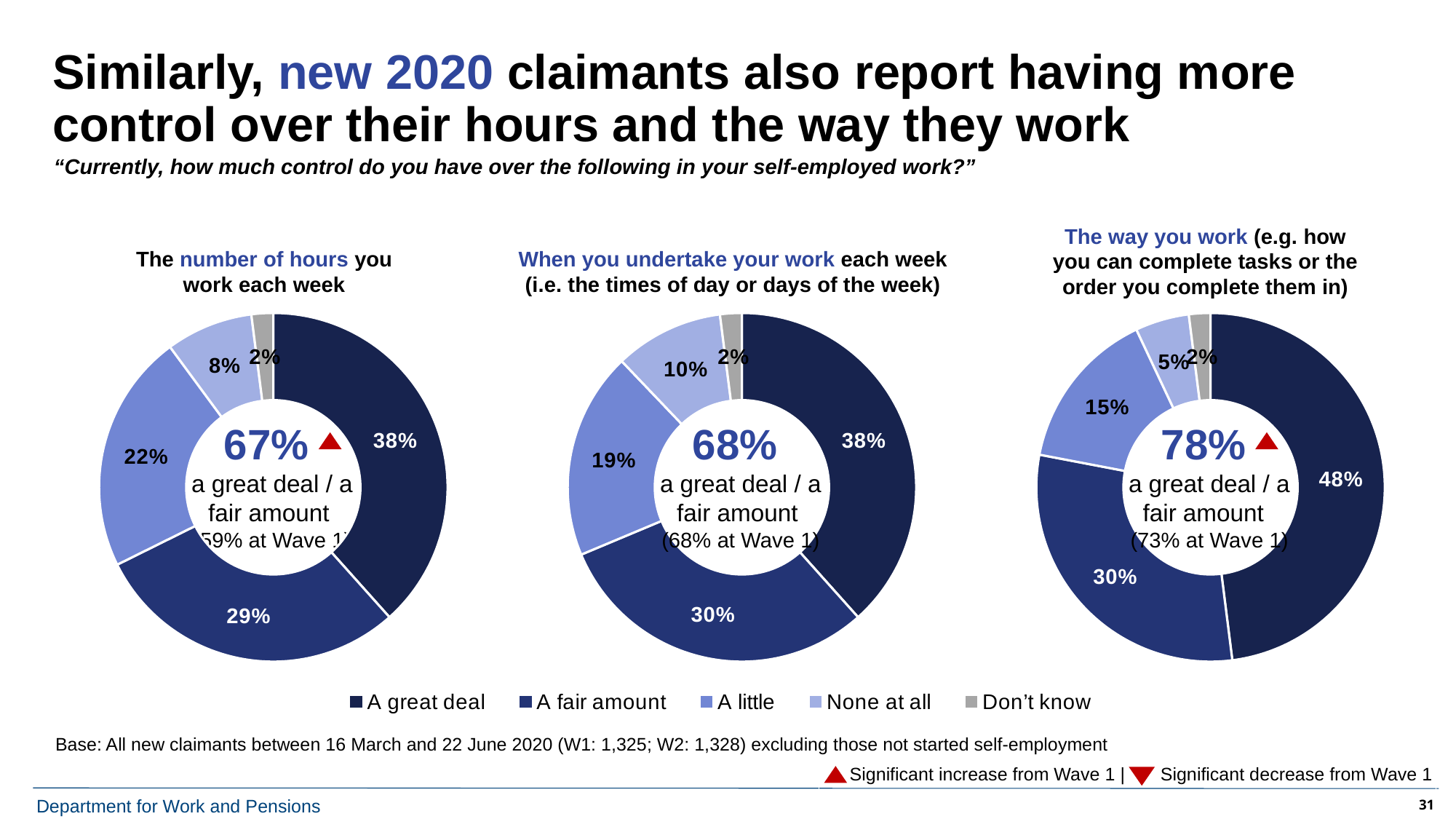
In the chart 'The way you work', which category has the largest share? A great deal In the chart 'The way you work', what percentage said 'None at all'? 5% What type of chart is used on this slide? Donut (pie) chart According to the centre of the chart 'The number of hours you work each week', what was the 'a great deal / a fair amount' figure at Wave 1? 59% In the chart 'When you undertake your work each week', what percentage said 'A little'? 19% In the chart 'The way you work', what is the difference between the 'A great deal' and 'A fair amount' shares? 18% In the chart 'The number of hours you work each week', which category has the smallest share? Don't know In the chart 'The number of hours you work each week', which is larger: 'A fair amount' or 'A little'? A fair amount What combined percentage of 'a great deal / a fair amount' is shown in the centre of the chart 'When you undertake your work each week'? 68% How many charts are shown on the slide? 3 How many series does the legend list? 5 In the chart 'The number of hours you work each week', what percentage of claimants said they have 'A great deal' of control? 38%